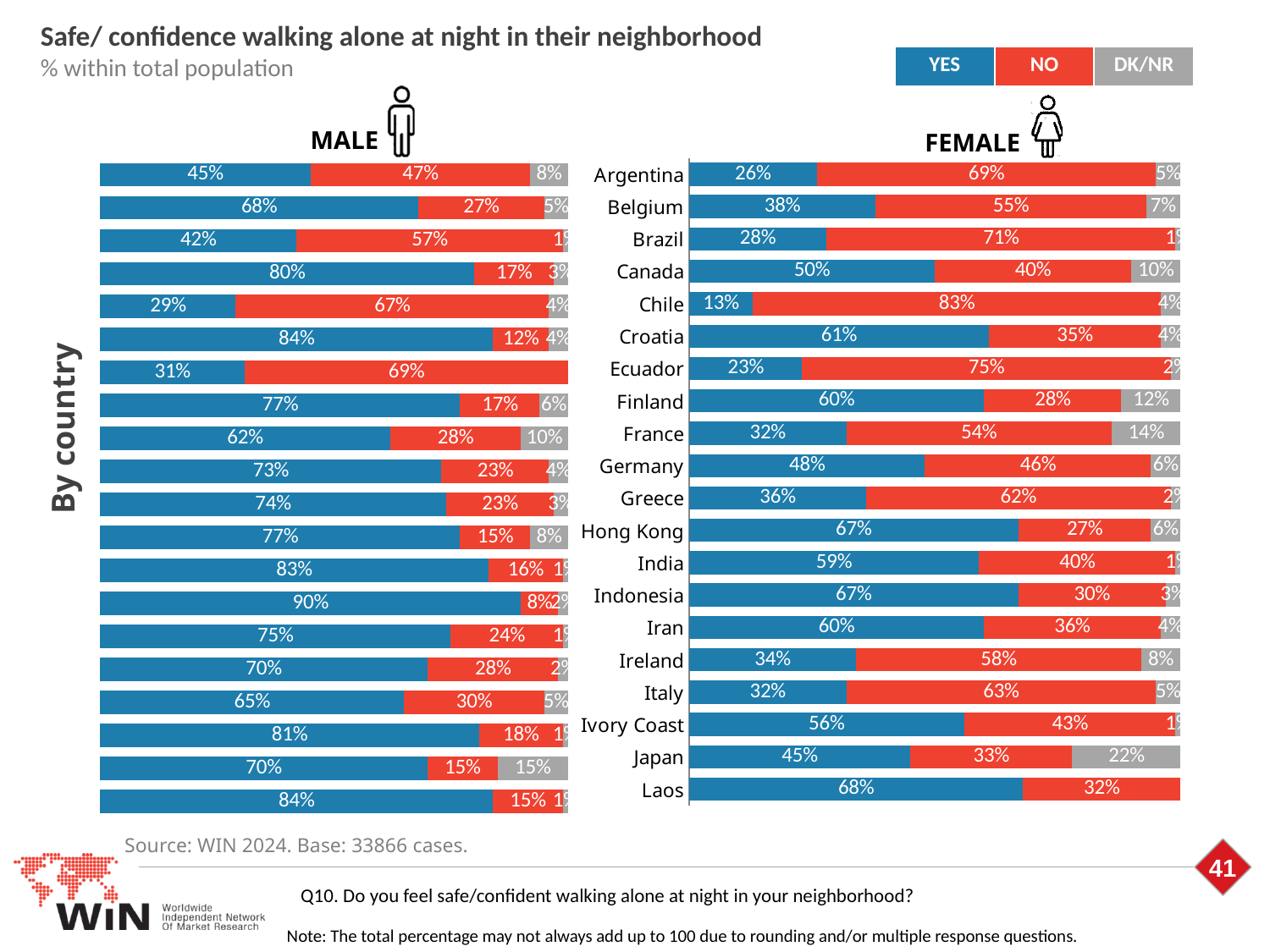
How many response categories does the legend list? 3 What is the difference between the YES percentage for men in Canada and the YES percentage for women in Canada? 30% In the FEMALE chart, which country has the highest DK/NR percentage? Japan How many countries are listed on the slide? 20 In the MALE chart, what percentage of men in Indonesia answered YES? 90% In the FEMALE chart, which country has the lowest YES percentage? Chile In the FEMALE chart, is the YES percentage higher for Croatia or for Ireland? Croatia What type of chart is used on this slide? Stacked bar chart In the FEMALE chart, what percentage of women in Chile answered NO? 83% What colour represents the NO responses in the charts? Red In the MALE chart, which country has the highest YES percentage? Indonesia In the FEMALE chart, what percentage of women in Japan answered YES? 45%